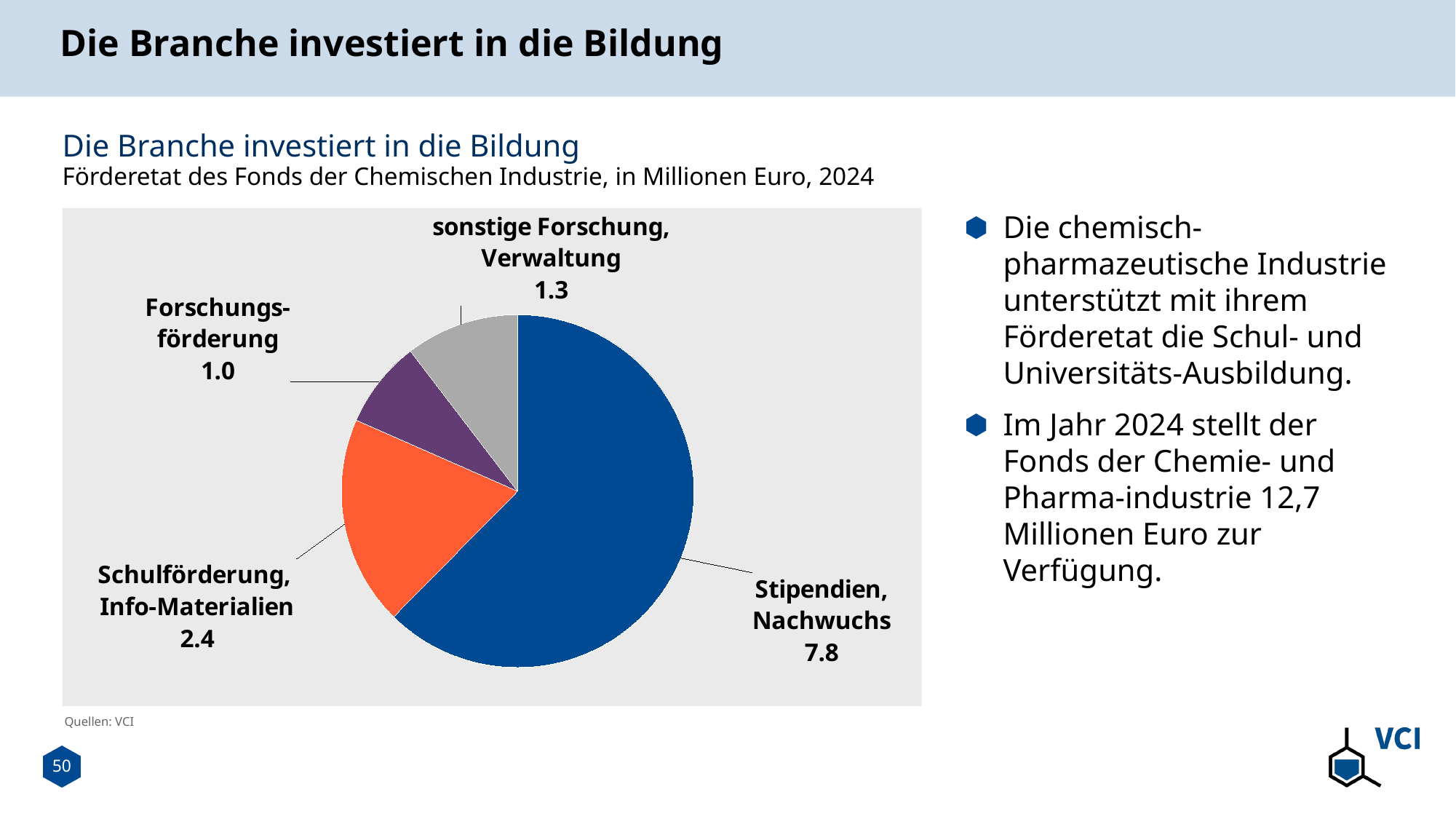
Which category has the smallest slice of the pie? Forschungsförderung What is the difference between the values for Stipendien, Nachwuchs and Schulförderung, Info-Materialien? 5.4 What is the value for Schulförderung, Info-Materialien? 2.4 In what unit are the values in the chart given, according to the subtitle? Millionen Euro What is the value for Forschungsförderung? 1.0 Which category has the largest slice of the pie? Stipendien, Nachwuchs What kind of chart is shown on the slide? Pie chart How many categories are shown in the pie chart? 4 What is the value for sonstige Forschung, Verwaltung? 1.3 What is the difference between the values for Schulförderung, Info-Materialien and Forschungsförderung? 1.4 What is the value for Stipendien, Nachwuchs in the pie chart? 7.8 Which is larger: sonstige Forschung, Verwaltung or Forschungsförderung? sonstige Forschung, Verwaltung